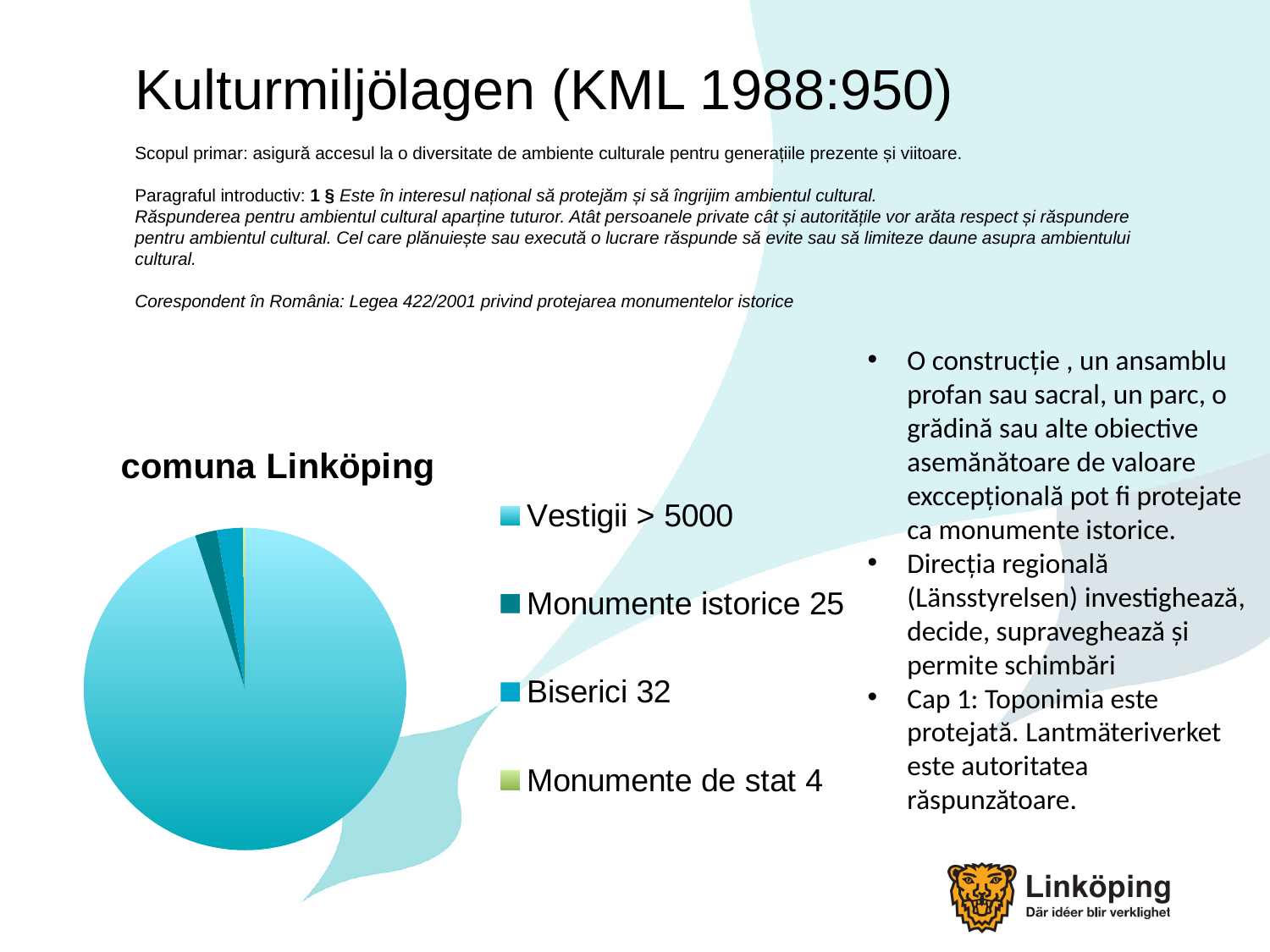
Which category has the smallest count in the legend? Monumente de stat 4 According to the legend, how many Monumente istorice are there? 25 Which legend entry is listed first in the pie chart's legend? Vestigii > 5000 What is the title of the pie chart? comuna Linköping How many categories does the pie chart's legend list? 4 Which is larger, the count for Biserici or the count for Monumente istorice? Biserici According to the legend, how many Monumente de stat are there? 4 Is the count for Vestigii greater or less than 5000? greater What kind of chart is shown on the slide? pie chart What is the difference between the count for Biserici and the count for Monumente istorice? 7 According to the legend, how many Biserici are there? 32 Which category takes up the largest share of the pie chart? Vestigii > 5000